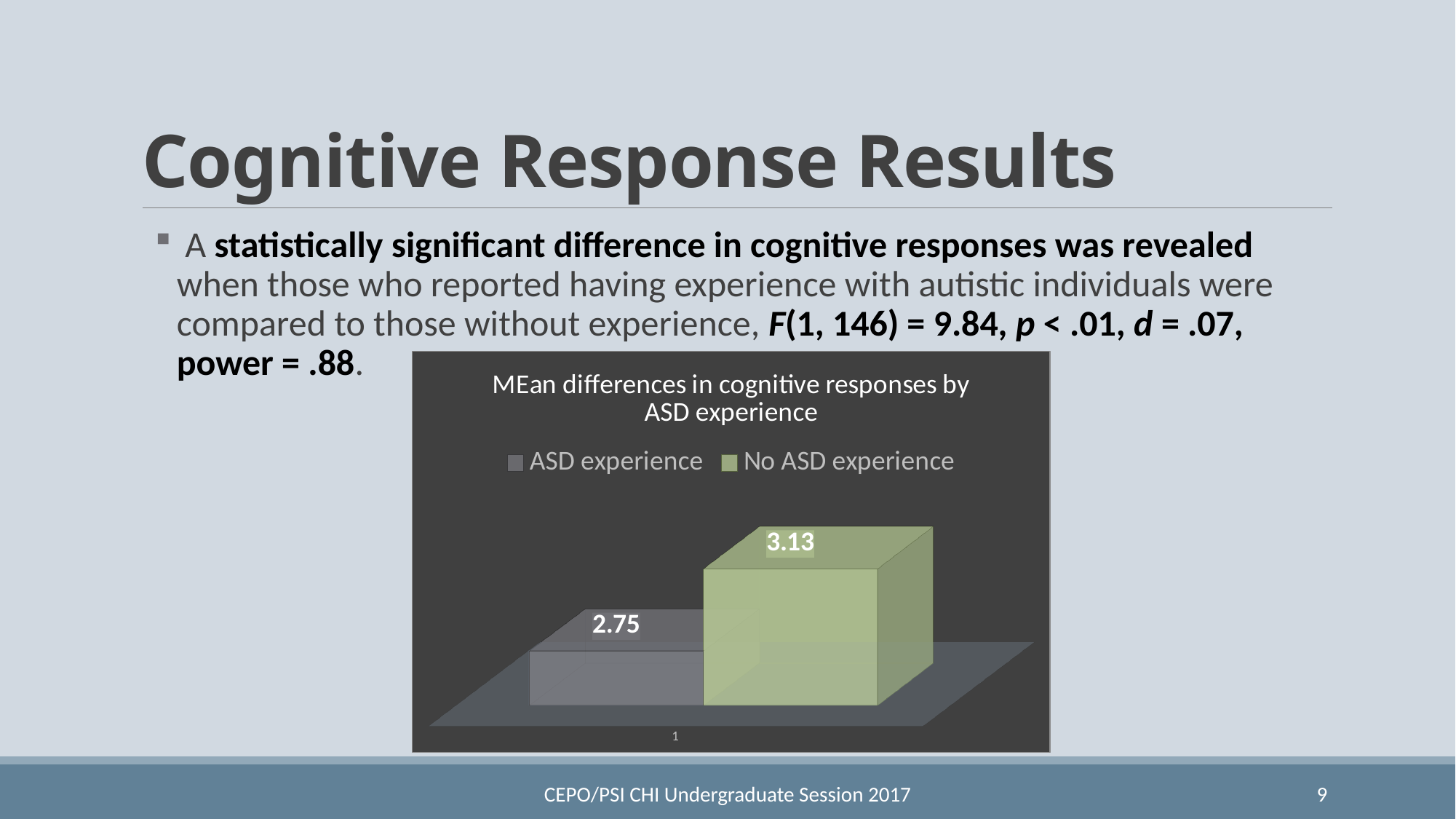
Is the value for ASD experience larger or smaller than the value for No ASD experience? smaller How many bars are plotted in the chart? 2 What is the title of the chart? MEan differences in cognitive responses by ASD experience What is the value for No ASD experience? 3.13 What kind of chart is shown on the slide? bar chart Which series has the higher value, ASD experience or No ASD experience? No ASD experience What is the value for ASD experience? 2.75 What is the difference between the No ASD experience value and the ASD experience value? 0.38 How many series does the legend list? 2 What colour is the bar for No ASD experience? green Which series has the lower value? ASD experience